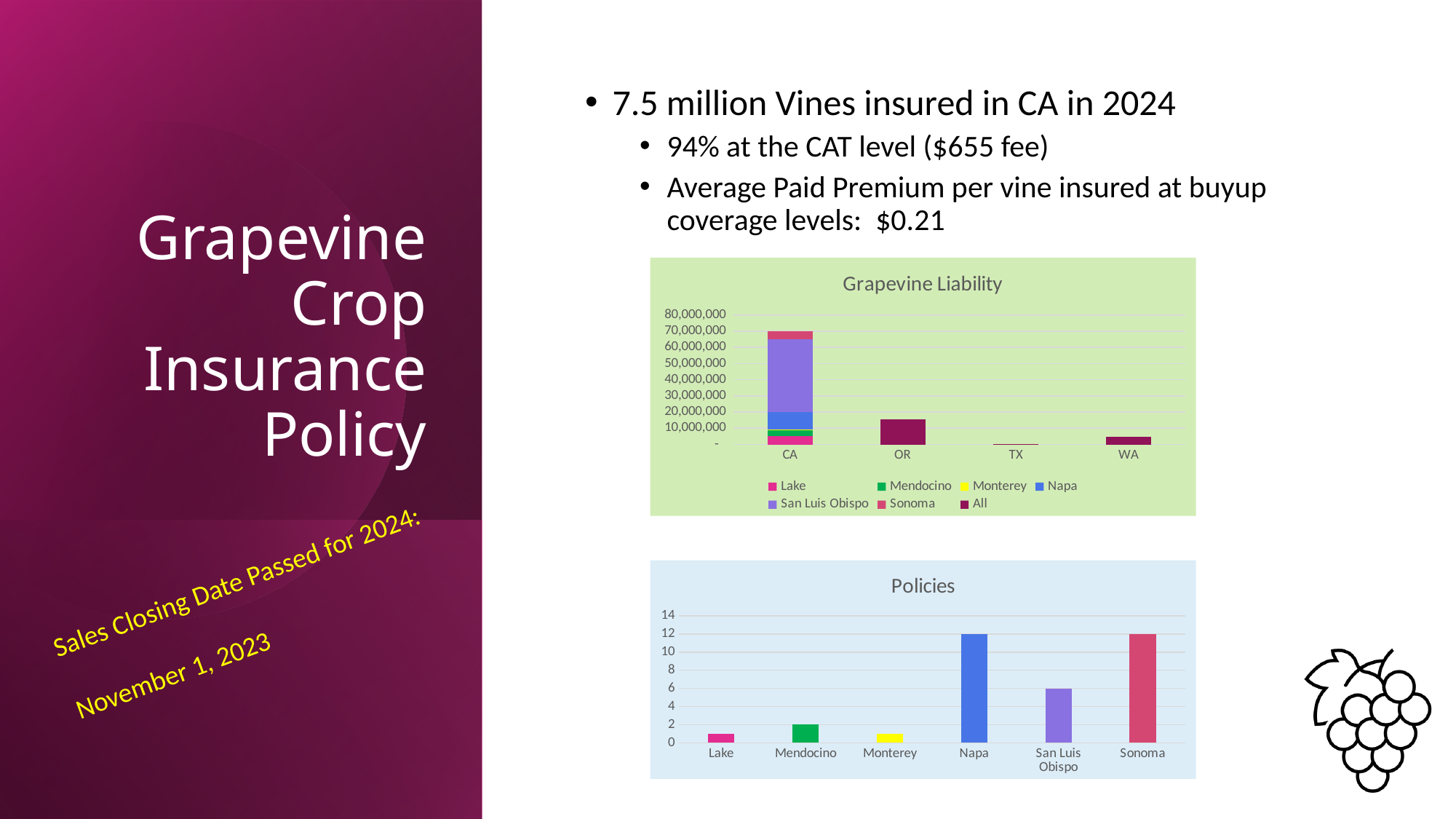
In the Policies chart, is the value for Lake greater or less than 2? less What kind of chart is the Grapevine Liability chart? Stacked bar chart In the Policies chart, which has more policies, Napa or San Luis Obispo? Napa In the Grapevine Liability chart, is the total value for OR greater or less than 10,000,000? greater In the Policies chart, what is the difference between the number of policies for Sonoma and for Mendocino? 10 In the Policies chart, how many policies are shown for San Luis Obispo? 6 How many categories are shown on the x axis of the Policies chart? 6 In the Policies chart, how many policies are shown for Napa? 12 In the Grapevine Liability chart, which state has the highest total liability? CA How many series does the legend of the Grapevine Liability chart list? 7 In the Policies chart, how many policies are shown for Mendocino? 2 In the Grapevine Liability chart, which state has the lowest total liability? TX